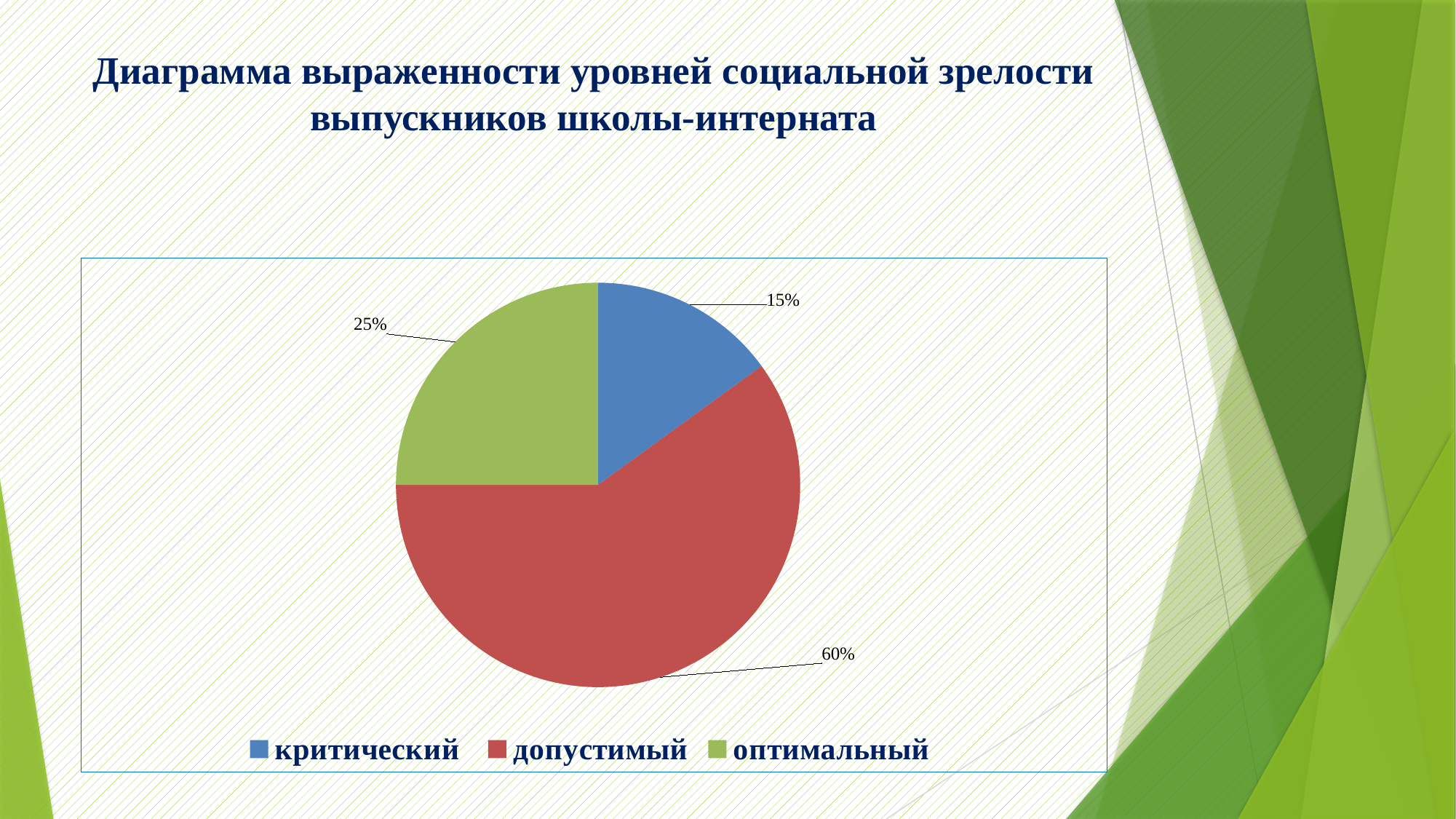
What is the difference in percentage points between the допустимый and оптимальный slices? 35 How many slices does the pie chart have? 3 How many entries does the legend list? 3 Which category has the largest slice of the pie? допустимый What type of chart is shown on the slide? pie chart What share of the pie does the допустимый slice represent? 60% What share of the pie does the критический slice represent? 15% What share of the pie does the оптимальный slice represent? 25% Which slice is larger, критический or оптимальный? оптимальный What colour is the допустимый slice? red What is the difference in percentage points between the оптимальный and критический slices? 10 Which category has the smallest slice of the pie? критический